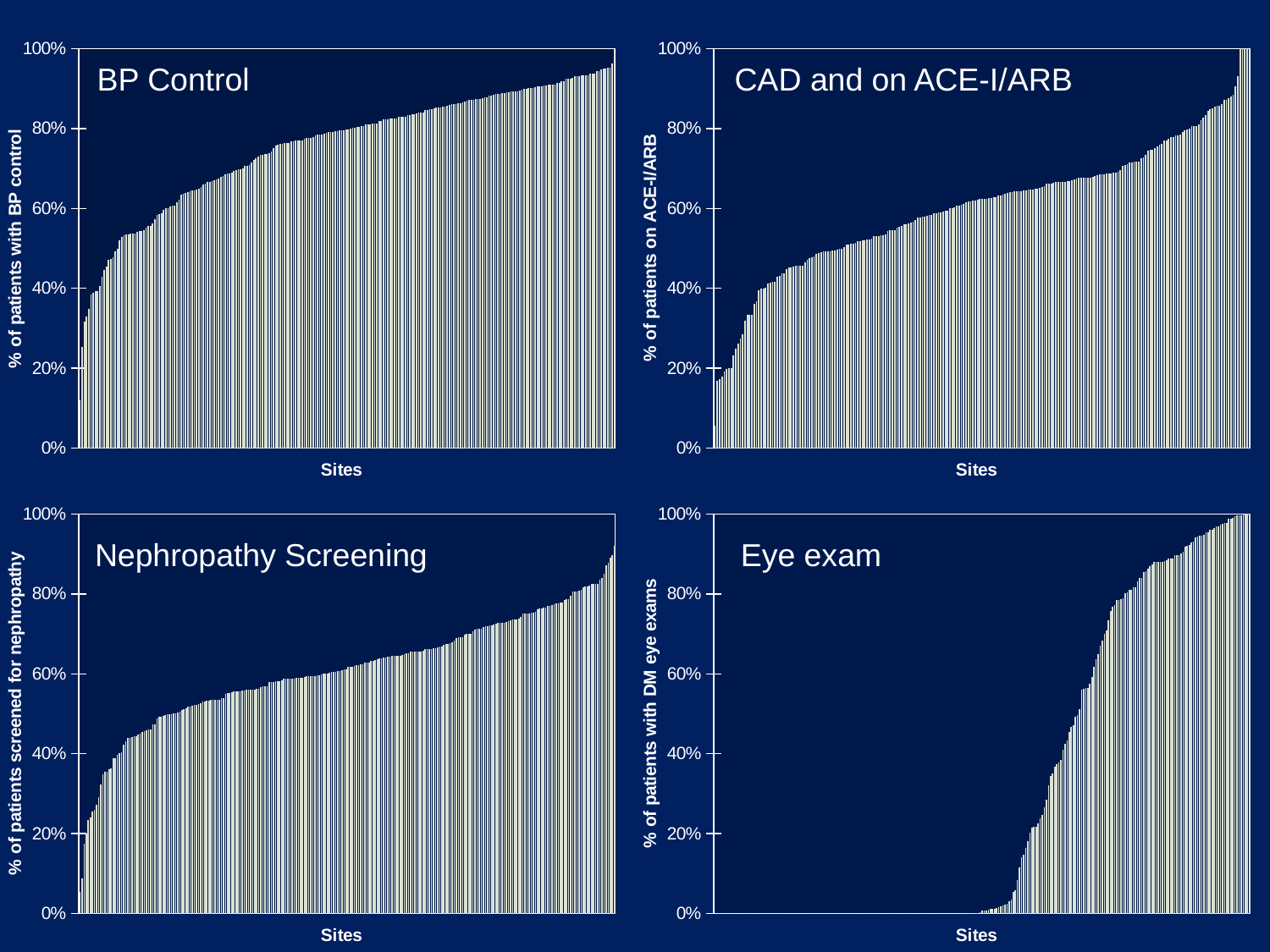
In the Eye exam chart, do the values rise or fall from left to right along the x axis? rise In the CAD and on ACE-I/ARB chart, is the value for the lowest site greater or less than 40%? less What is the y-axis label of the Eye exam chart? % of patients with DM eye exams What kind of chart is the Eye exam chart? bar chart In the BP Control chart, do the values rise or fall from left to right along the x axis? rise In the Eye exam chart, is the value for the lowest site greater or less than 20%? less In the Nephropathy Screening chart, do the values rise or fall from left to right along the x axis? rise In the BP Control chart, is the value for the lowest site greater or less than 60%? less What kind of chart is the BP Control chart? bar chart How many charts are shown on the slide? 4